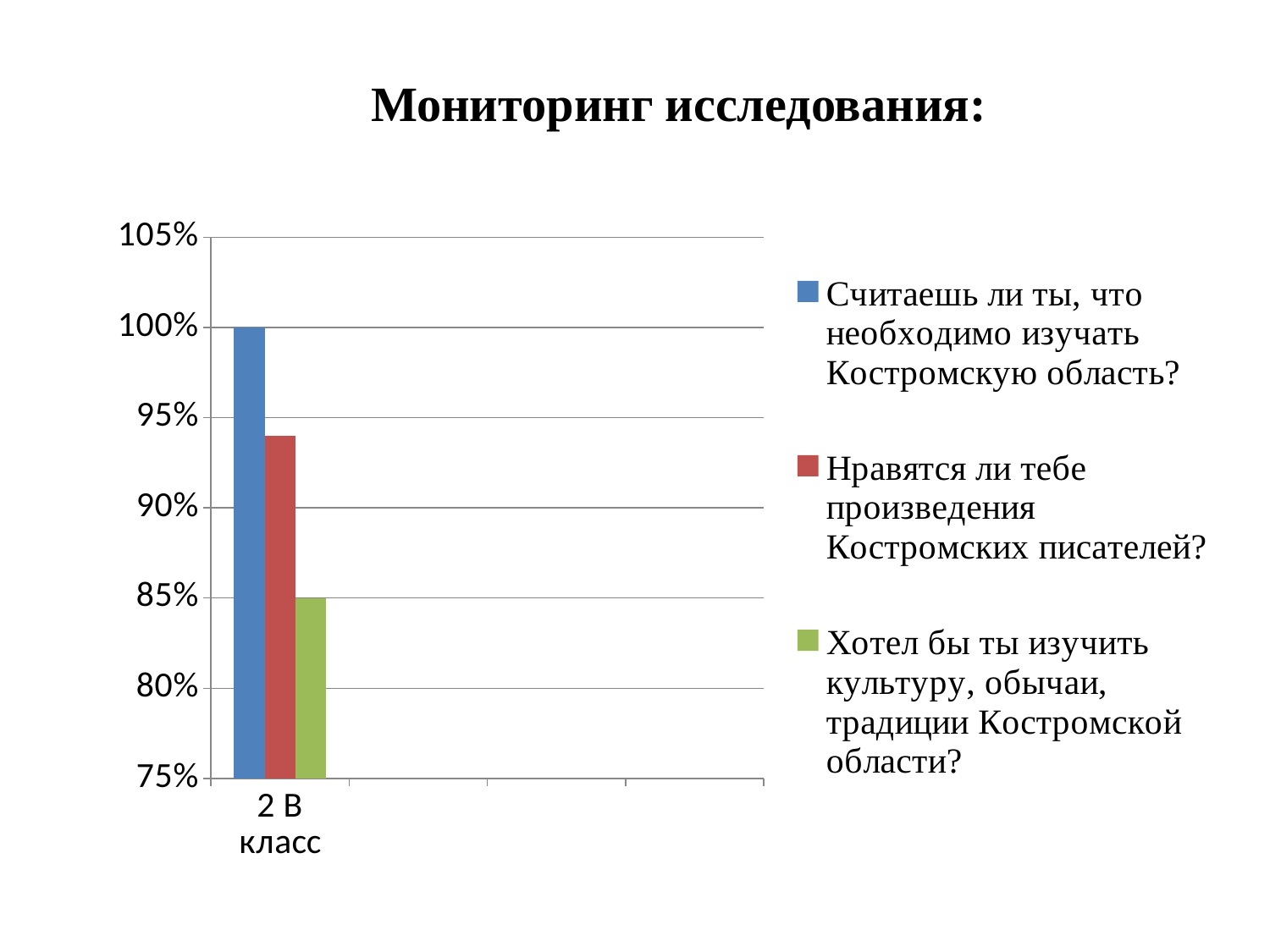
Is the value for 'Нравятся ли тебе произведения Костромских писателей?' greater or less than 90%? greater What is the value for 'Хотел бы ты изучить культуру, обычаи, традиции Костромской области?' for 2 В класс? 85% What is the difference between the value for 'Считаешь ли ты, что необходимо изучать Костромскую область?' and the value for 'Хотел бы ты изучить культуру, обычаи, традиции Костромской области?'? 15% Which series has the highest value for 2 В класс? Считаешь ли ты, что необходимо изучать Костромскую область? What kind of chart is shown on the slide? bar chart Is the value for 'Нравятся ли тебе произведения Костромских писателей?' greater or less than 95%? less What is the value for 'Считаешь ли ты, что необходимо изучать Костромскую область?' for 2 В класс? 100% Which is larger: the value for 'Нравятся ли тебе произведения Костромских писателей?' or the value for 'Хотел бы ты изучить культуру, обычаи, традиции Костромской области?'? Нравятся ли тебе произведения Костромских писателей? Which series has the lowest value for 2 В класс? Хотел бы ты изучить культуру, обычаи, традиции Костромской области? How many categories are shown on the x axis? 1 What is the category label on the x axis? 2 В класс How many series does the legend list? 3